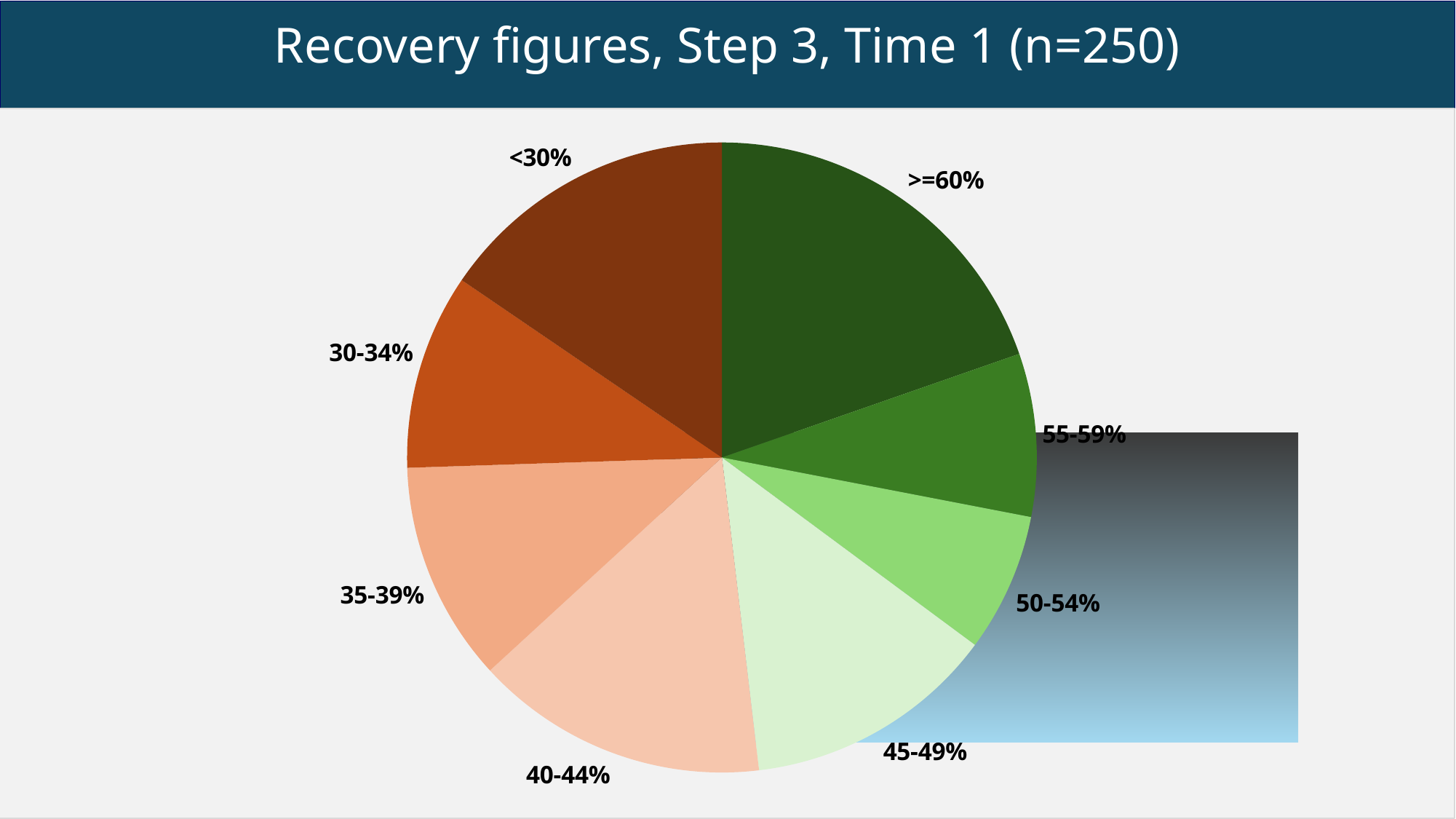
What kind of chart is shown on the slide? pie chart Which slice is larger, 40-44% or 30-34%? 40-44% Which slice is larger, >=60% or 55-59%? >=60% What colour is the >=60% slice? dark green Which category has the largest slice of the pie? >=60% How many slices does the pie chart have? 8 What is the title of the chart? Recovery figures, Step 3, Time 1 (n=250) Which slice is larger, <30% or 35-39%? <30%